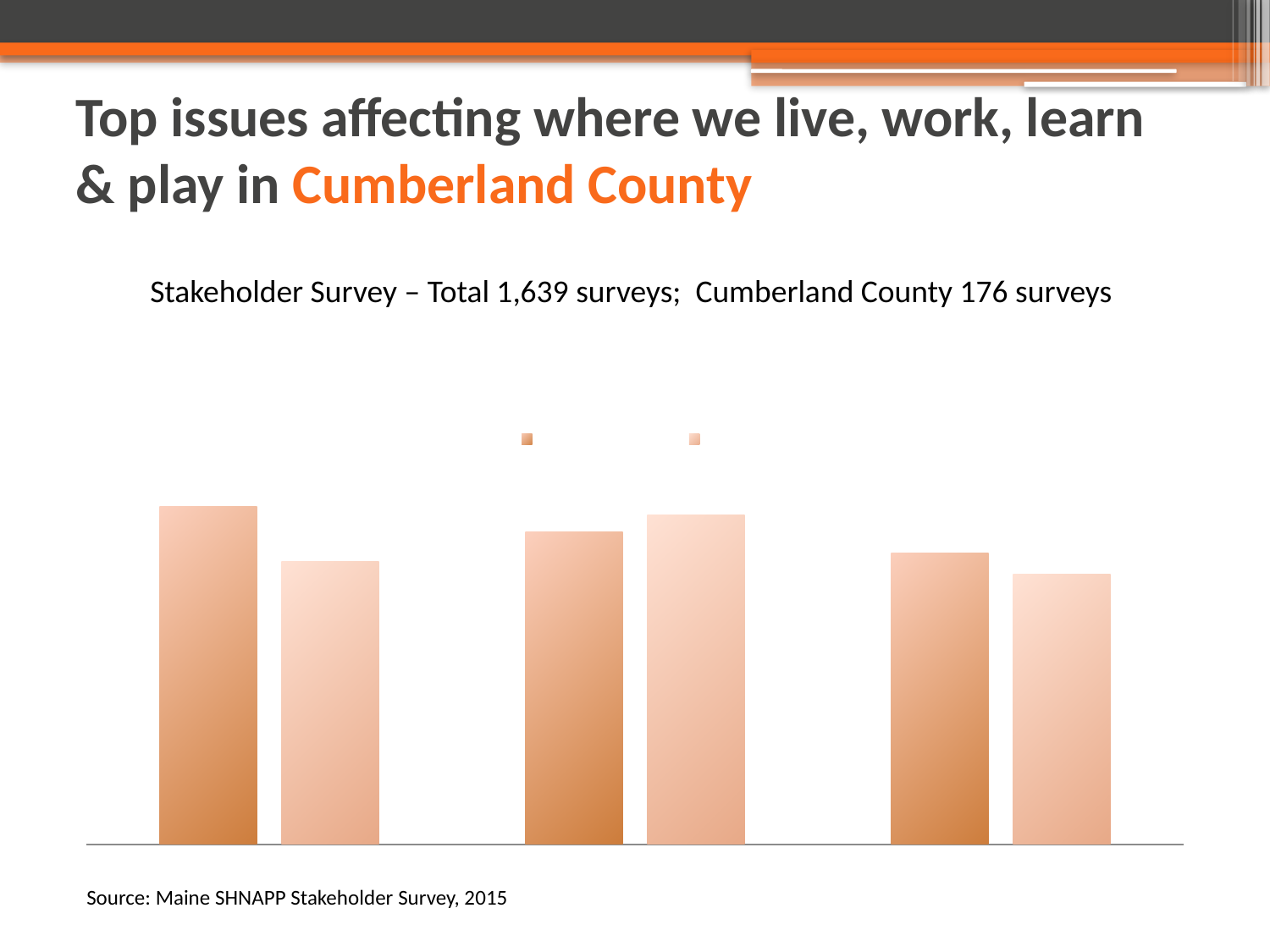
What source is cited below the chart? Maine SHNAPP Stakeholder Survey, 2015 How many series does the chart's legend show? 2 What kind of chart is shown on the slide? bar chart Does the chart display any numeric data labels on its bars? No Which group of bars contains the shortest bar in the chart: the leftmost, middle, or rightmost? the rightmost Which group of bars contains the tallest bar in the chart: the leftmost, middle, or rightmost? the leftmost How many bars are plotted in the chart in total? 6 In the rightmost group of bars, is the darker bar or the lighter bar taller? the darker bar In the middle group of bars, is the darker bar or the lighter bar taller? the lighter bar In the leftmost group of bars, is the darker bar or the lighter bar taller? the darker bar How many groups of bars are plotted in the chart? 3